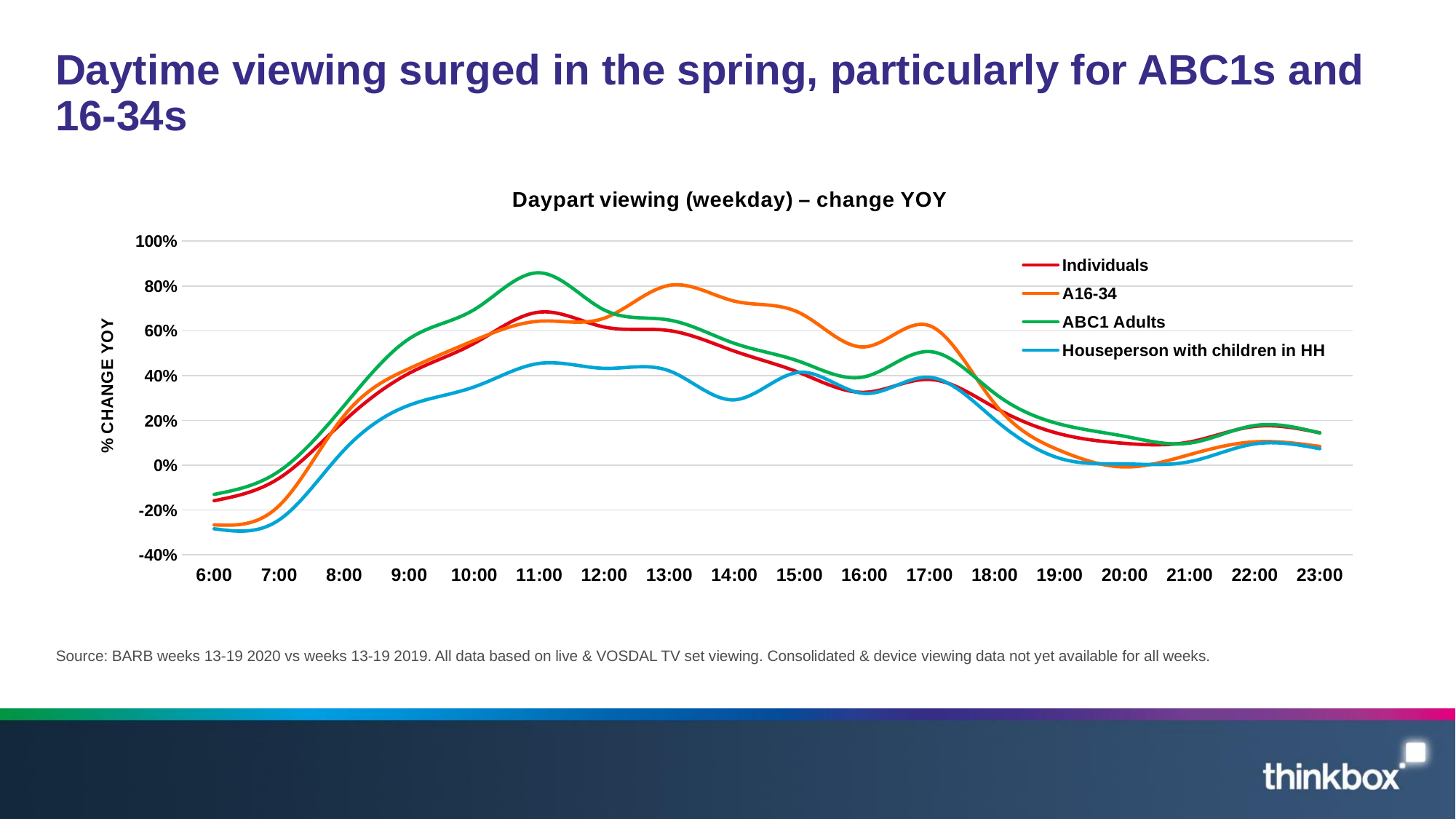
Which series reaches the highest value anywhere on the chart? ABC1 Adults Which series has the highest value at 13:00? A16-34 What is the title of the chart? Daypart viewing (weekday) – change YOY How many series does the legend list? 4 Is the value for ABC1 Adults at 11:00 greater or less than 80%? greater Is the value for Houseperson with children in HH at 6:00 greater or less than -20%? less How many time points are labelled on the x axis? 18 What kind of chart is shown on the slide? Line chart At 11:00, which is larger: ABC1 Adults or Houseperson with children in HH? ABC1 Adults Is the value for A16-34 at 13:00 greater or less than 60%? greater Does the Individuals line rise or fall between 11:00 and 20:00? Fall